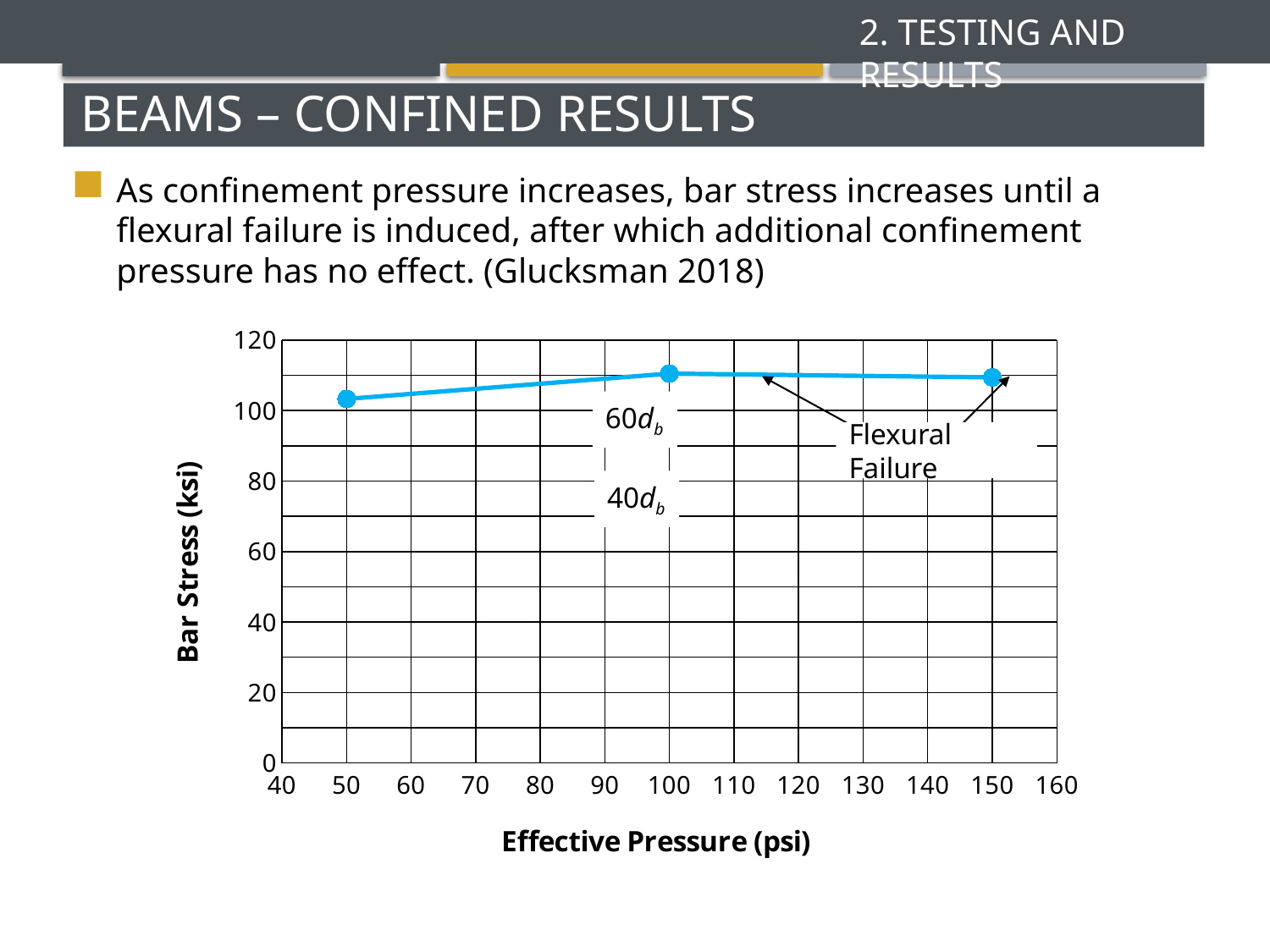
Is the bar stress at an effective pressure of 50 psi greater or less than 80 ksi? greater At which effective pressure is the plotted bar stress lowest? 50 psi What is the label of the vertical axis? Bar Stress (ksi) How does bar stress change as effective pressure increases from 50 psi to 100 psi? it rises Which has the higher bar stress: the point at 50 psi or the point at 100 psi? 100 psi Is the bar stress at an effective pressure of 100 psi greater or less than 100 ksi? greater What kind of chart is shown on the slide? line chart Is the bar stress at an effective pressure of 150 psi greater or less than 120 ksi? less How many data points are plotted on the chart? 3 What is the label of the horizontal axis? Effective Pressure (psi)